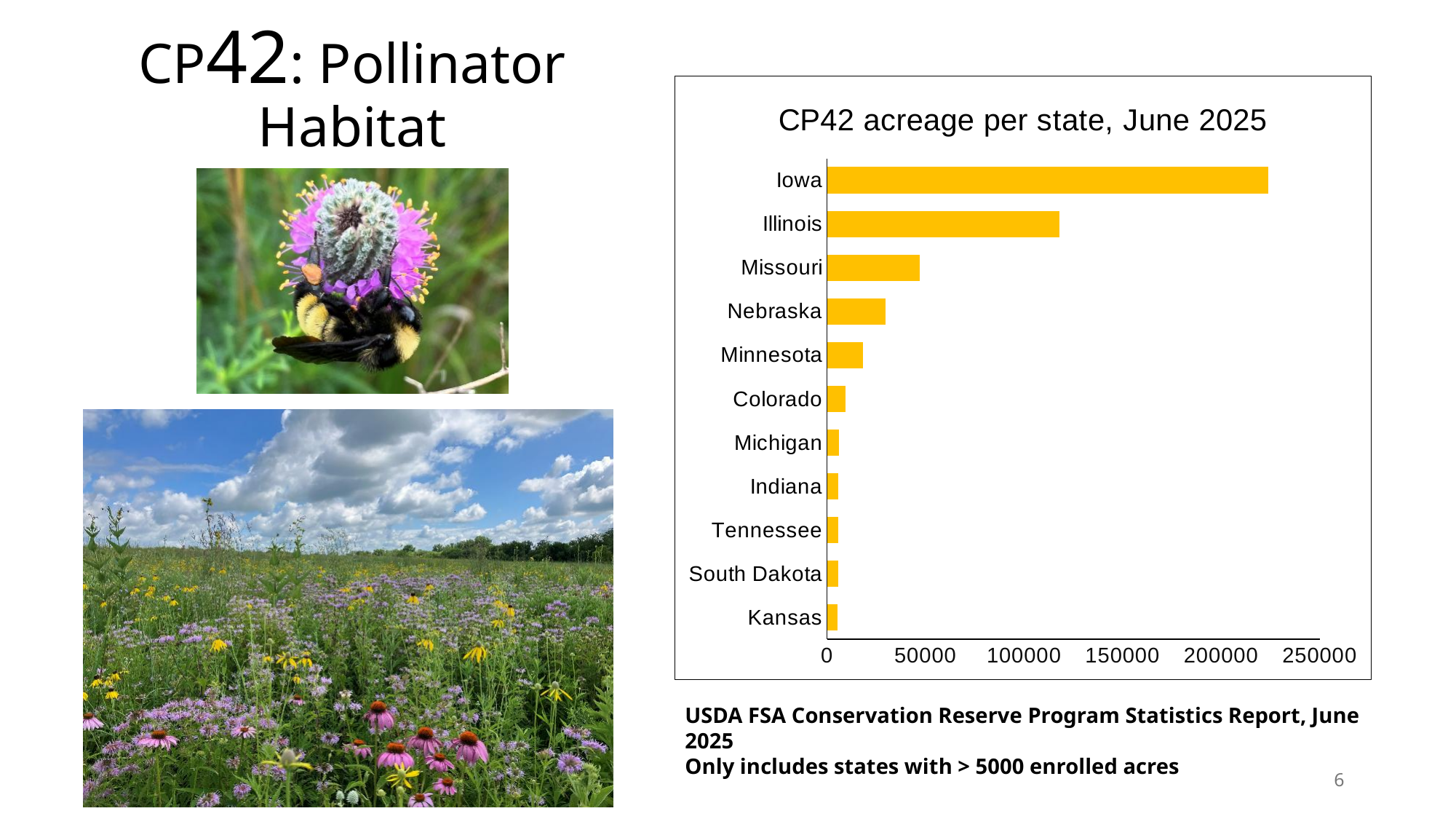
Which has a larger CP42 acreage, Missouri or Nebraska? Missouri Which has a larger CP42 acreage, Minnesota or Colorado? Minnesota Which state has the highest CP42 acreage? Iowa Is the value for Illinois greater or less than 150000? less Is the value for Illinois greater or less than 100000? greater Is the value for Nebraska greater or less than 50000? less How many states are shown in the chart? 11 What colour are the bars in the chart? Yellow What is the title of the chart? CP42 acreage per state, June 2025 What kind of chart is shown on the slide? Bar chart